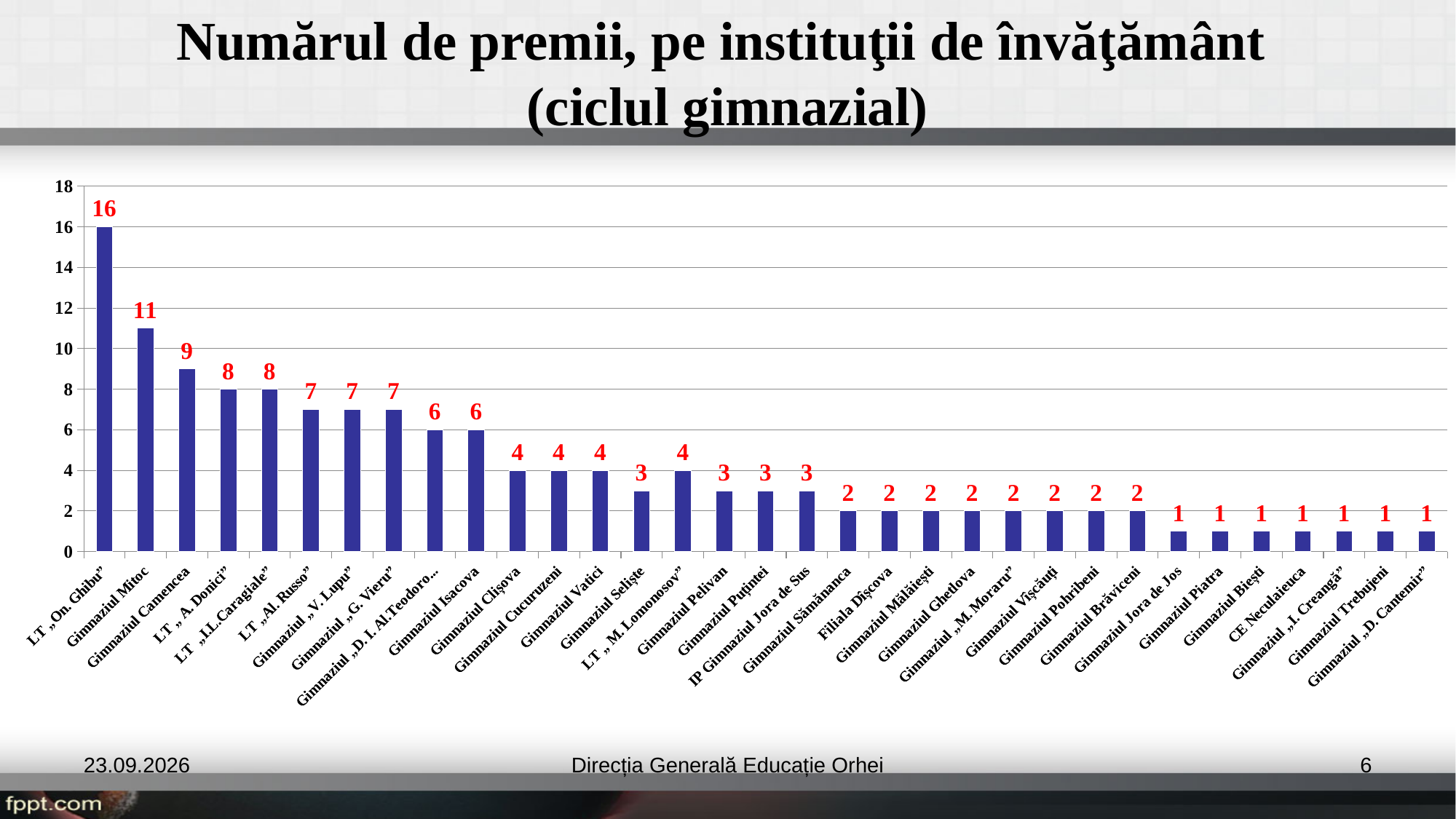
How many prizes does LT „On. Ghibu” have? 16 What is the value for Gimnaziul Camencea? 9 What is the value for LT „M. Lomonosov”? 4 Is the value for Gimnaziul Mitoc greater or less than 10? greater What is the value for Gimnaziul Seliște? 3 What is the title of the chart? Numărul de premii, pe instituţii de învăţământ (ciclul gimnazial) Which institution has the highest number of prizes? LT „On. Ghibu” What is the difference between the values for LT „On. Ghibu” and Gimnaziul Mitoc? 5 Which has a larger value, Gimnaziul Isacova or Gimnaziul Clișova? Gimnaziul Isacova Do the values rise or fall from left to right along the x axis? Fall How many institutions are shown on the chart? 33 What kind of chart is shown on the slide? Bar chart